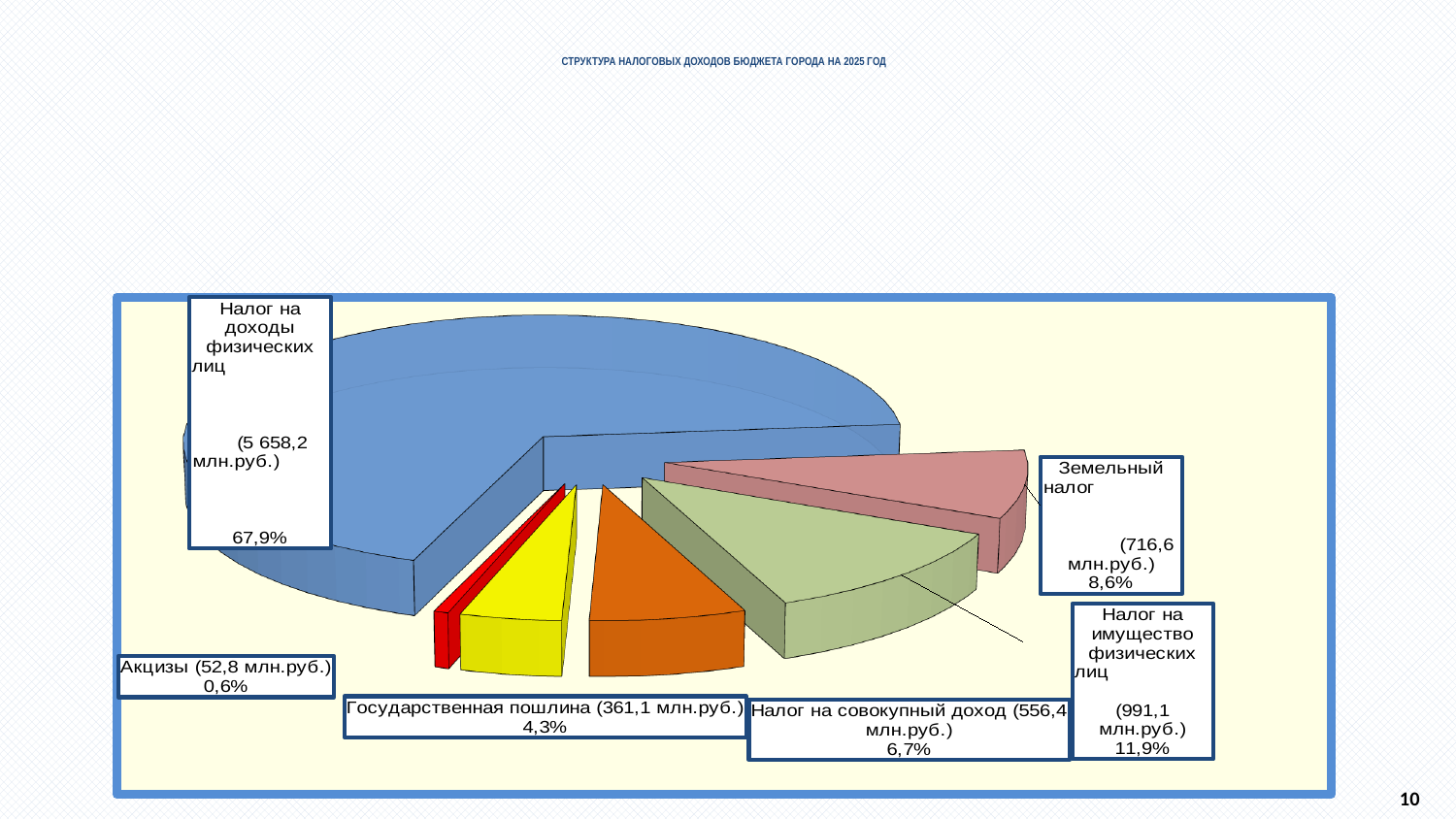
What is the value shown for "Акцизы"? 52,8 млн.руб. What is the difference in percentage points between "Налог на имущество физических лиц" (11,9%) and "Земельный налог" (8,6%)? 3,3% What is the title of the chart on the slide? СТРУКТУРА НАЛОГОВЫХ ДОХОДОВ БЮДЖЕТА ГОРОДА НА 2025 ГОД What share of the pie does "Налог на доходы физических лиц" represent? 67,9% What percentage is shown for "Налог на имущество физических лиц"? 11,9% What percentage is shown for "Государственная пошлина"? 4,3% Which is larger: "Земельный налог" or "Налог на совокупный доход"? Земельный налог What is the value shown for "Земельный налог"? 716,6 млн.руб. How many slices does the pie chart have? 6 Which slice of the pie is the largest? Налог на доходы физических лиц What kind of chart is shown on the slide? pie chart Which slice of the pie is the smallest? Акцизы